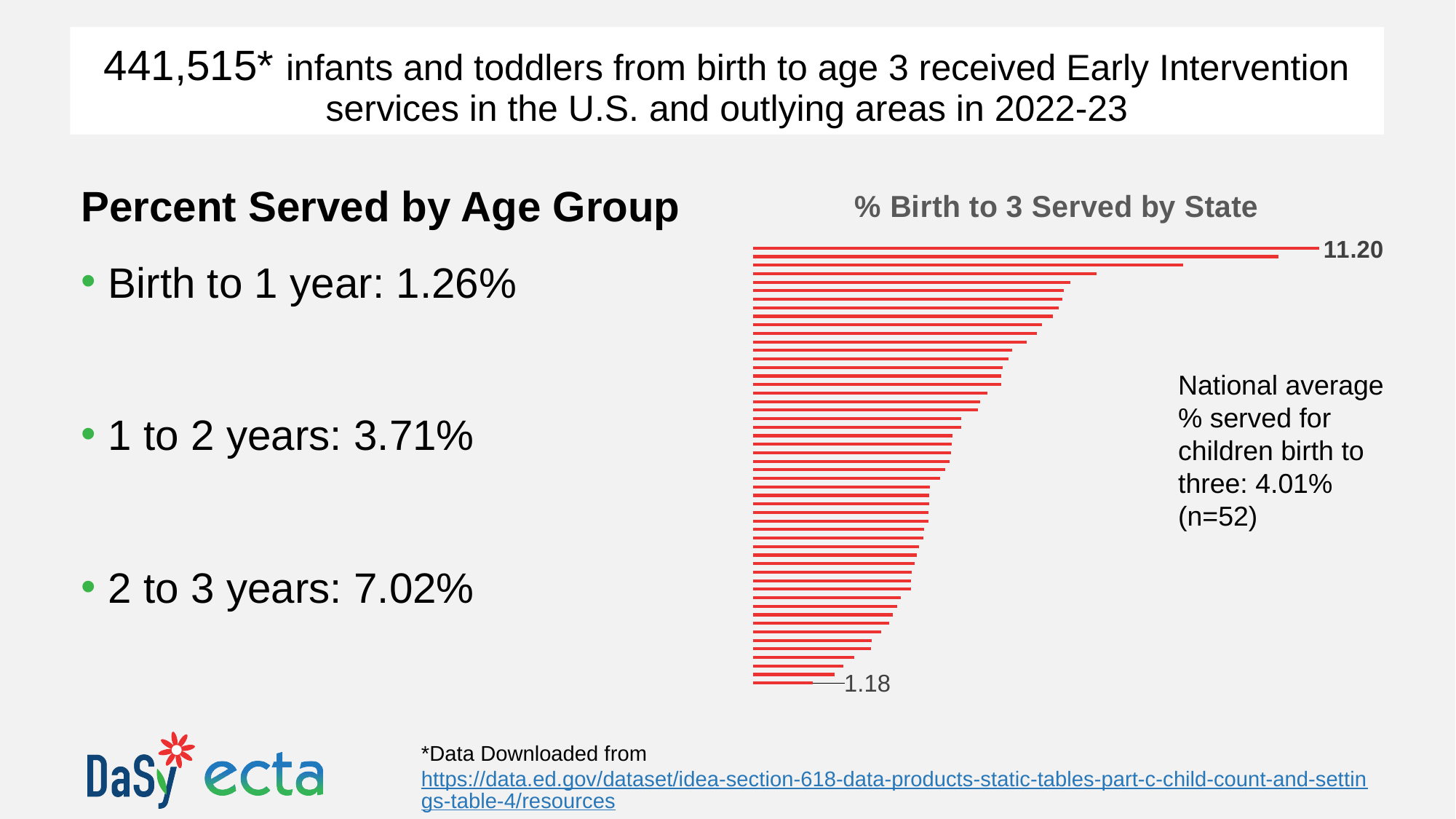
Is the highest value in the "% Birth to 3 Served by State" chart greater or less than 10? greater According to the slide, what is the national average % served for children birth to three? 4.01% In the "% Birth to 3 Served by State" chart, what is the lowest value shown? 1.18 Is the lowest value in the "% Birth to 3 Served by State" chart greater or less than 2? less What is the title of the chart on the slide? % Birth to 3 Served by State How many states (n) are represented in the "% Birth to 3 Served by State" chart, according to the slide? 52 What colour are the bars in the "% Birth to 3 Served by State" chart? red In the "% Birth to 3 Served by State" chart, do the bar values increase or decrease from the top of the chart to the bottom? decrease In the "% Birth to 3 Served by State" chart, what is the difference between the highest labeled value and the lowest labeled value? 10.02 In the "% Birth to 3 Served by State" chart, is the top bar larger or smaller than the bottom bar? larger What kind of chart is "% Birth to 3 Served by State"? bar chart In the "% Birth to 3 Served by State" chart, what is the highest value shown? 11.20